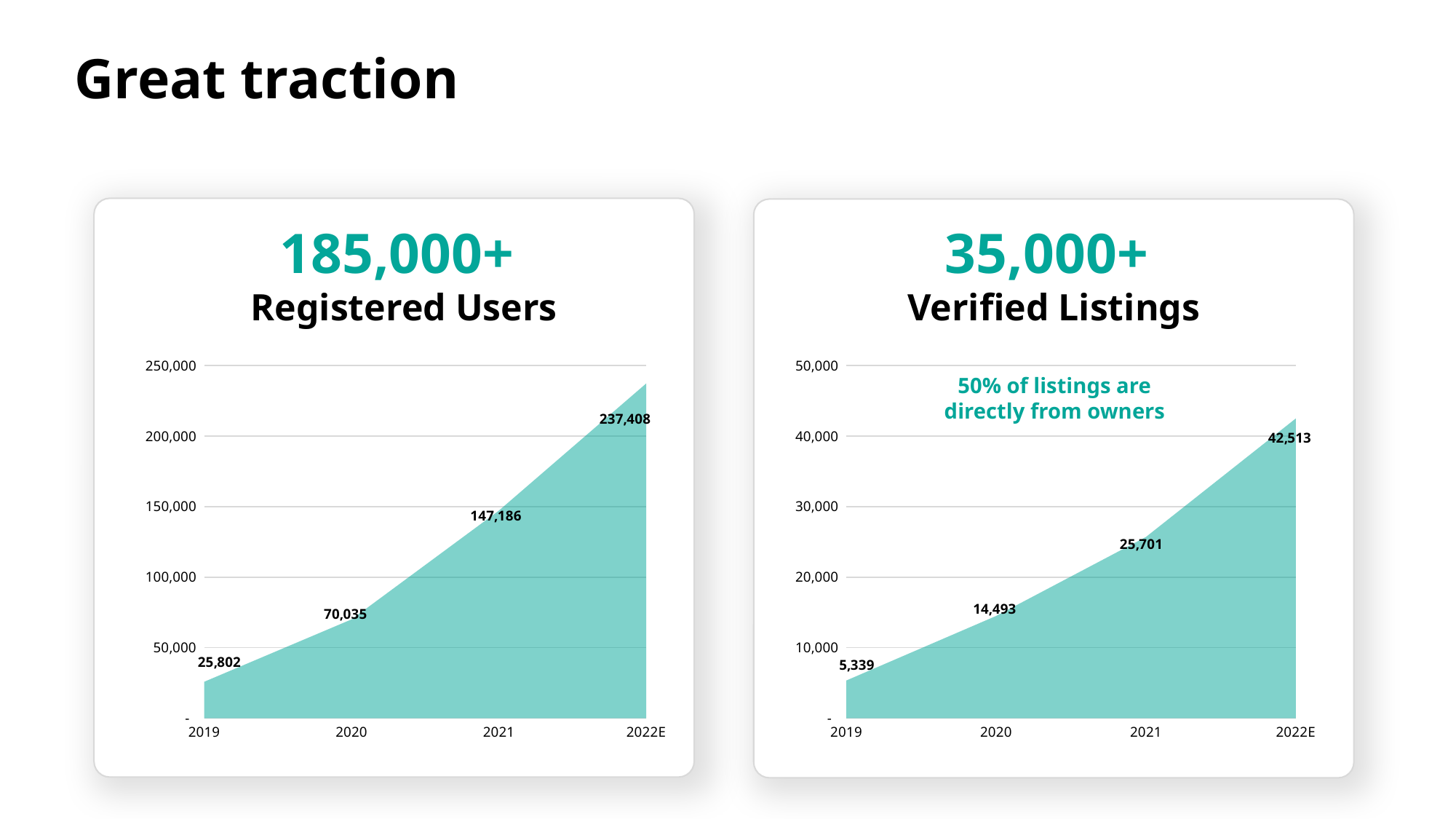
What kind of chart is the Verified Listings chart? area chart In the Verified Listings chart, what is the difference between the 2021 and 2020 values? 11,208 In the Verified Listings chart, is the value for 2021 greater or less than 30,000? less In the Registered Users chart, what is the value for 2021? 147,186 In the Registered Users chart, what is the difference between the 2022E and 2021 values? 90,222 In the Verified Listings chart, what is the value for 2020? 14,493 In the Registered Users chart, do the values rise or fall from 2019 to 2022E? rise How many years are plotted on the Registered Users chart? 4 In the Registered Users chart, which year has the lowest value? 2019 In the Registered Users chart, which is larger, the value for 2020 or the value for 2021? 2021 What is the headline figure shown above the Verified Listings chart? 35,000+ In the Verified Listings chart, which year has the highest value? 2022E